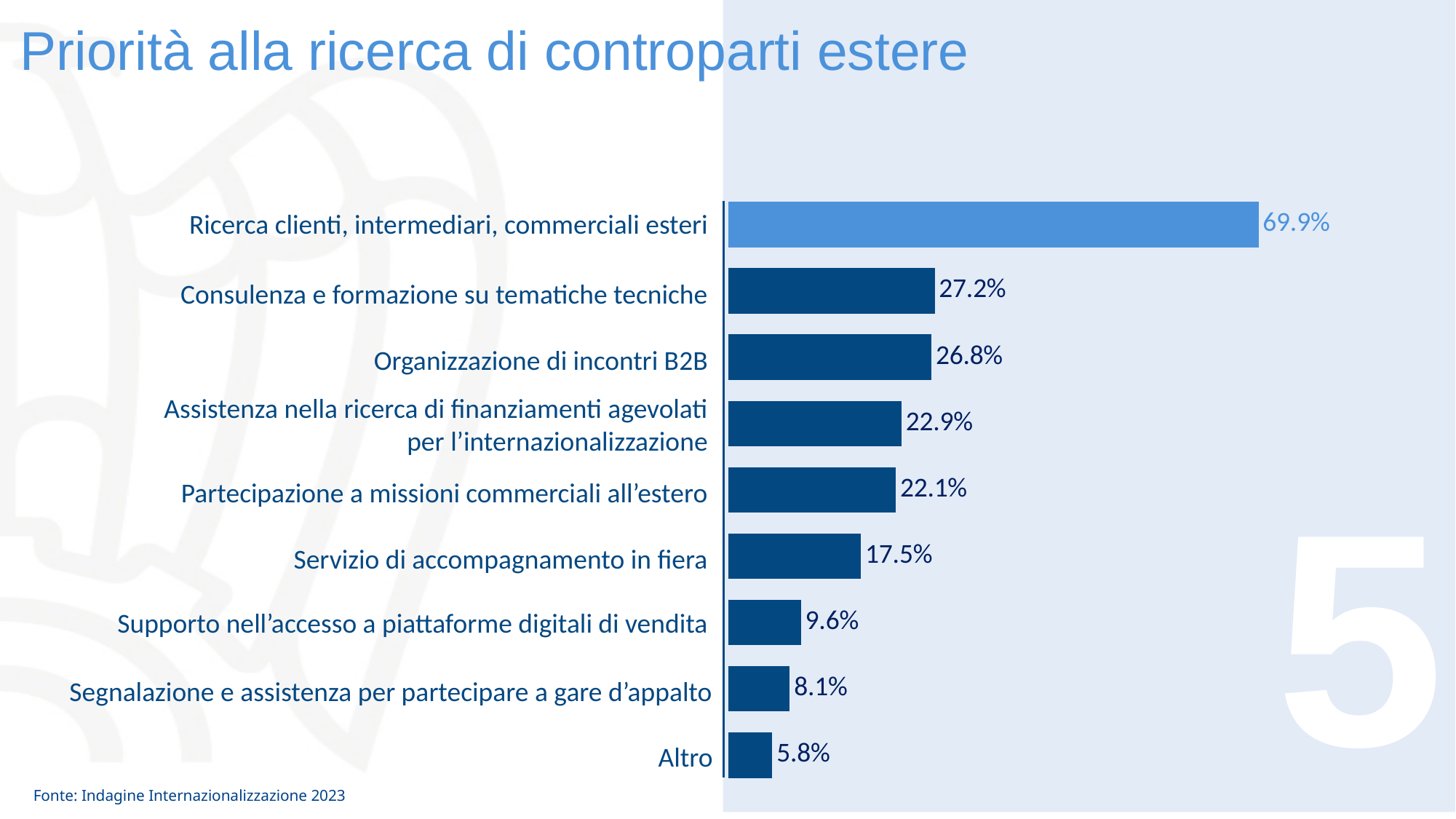
What is the value for "Organizzazione di incontri B2B"? 26.8% What is the source cited at the bottom of the slide? Indagine Internazionalizzazione 2023 Which category has the lowest value? Altro What is the value for "Servizio di accompagnamento in fiera"? 17.5% Which is larger: "Supporto nell'accesso a piattaforme digitali di vendita" or "Segnalazione e assistenza per partecipare a gare d'appalto"? Supporto nell'accesso a piattaforme digitali di vendita What is the value for "Ricerca clienti, intermediari, commerciali esteri"? 69.9% What is the difference between "Consulenza e formazione su tematiche tecniche" and "Organizzazione di incontri B2B"? 0.4% What is the value for "Altro"? 5.8% How many categories are shown in the chart? 9 What is the difference between "Ricerca clienti, intermediari, commerciali esteri" and "Altro"? 64.1% What kind of chart is shown on the slide? Bar chart Which category has the highest value? Ricerca clienti, intermediari, commerciali esteri